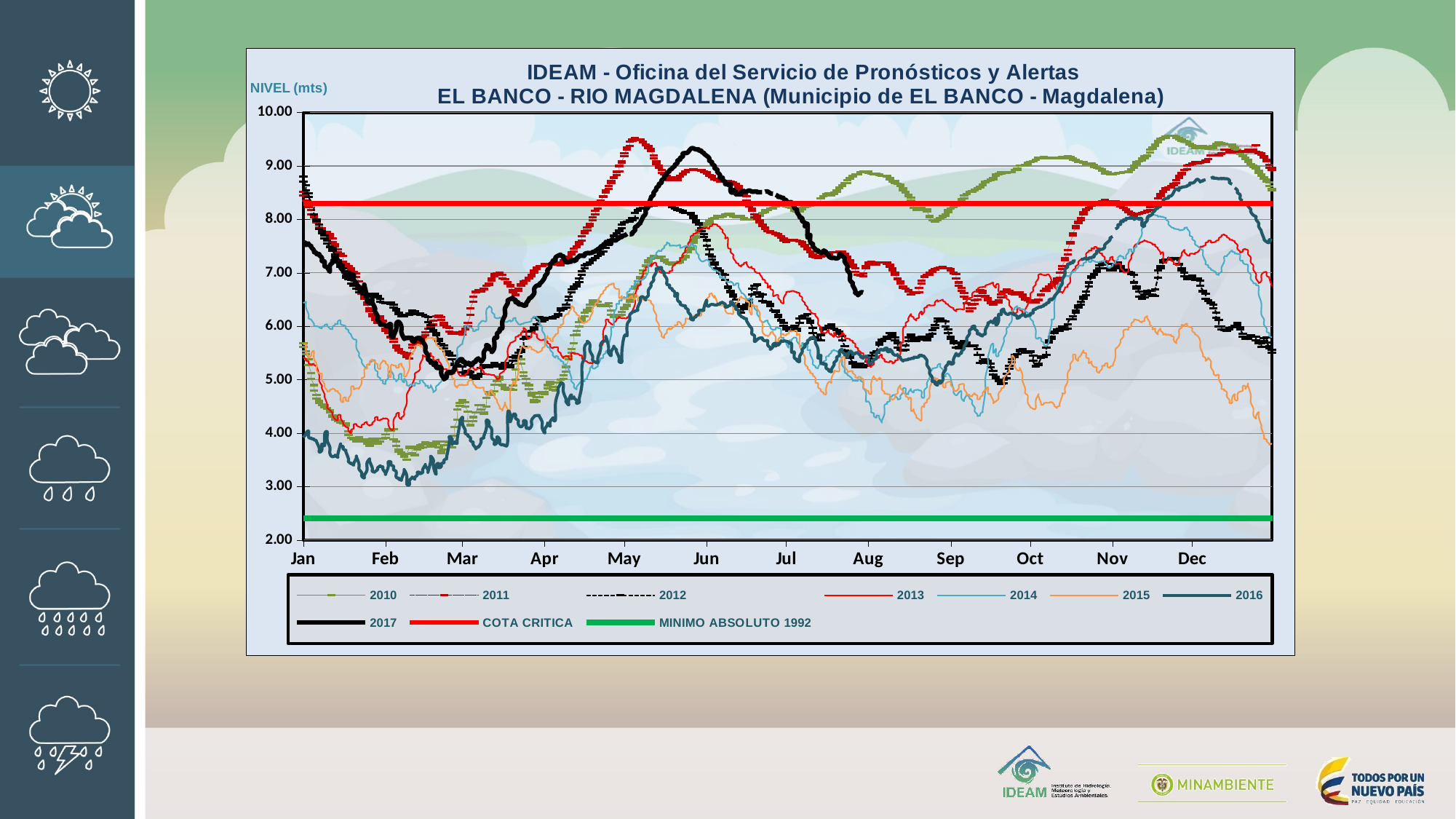
Which series is higher in November, 2010 or 2015? 2010 Is the MINIMO ABSOLUTO 1992 line greater or less than 3.00? less Does the 2015 series rise or fall from November to December? fall Which series is lower in February, 2016 or 2010? 2016 Is the peak of the 2017 series, reached around late May, greater or less than 9.00? greater What kind of chart is shown on the slide? line chart Is the value of the 2015 series at the end of December greater or less than 4.00? less What is the label of the y axis? NIVEL (mts) What colour is the COTA CRITICA line? red How many months are labelled along the x axis? 12 How many series does the legend list? 10